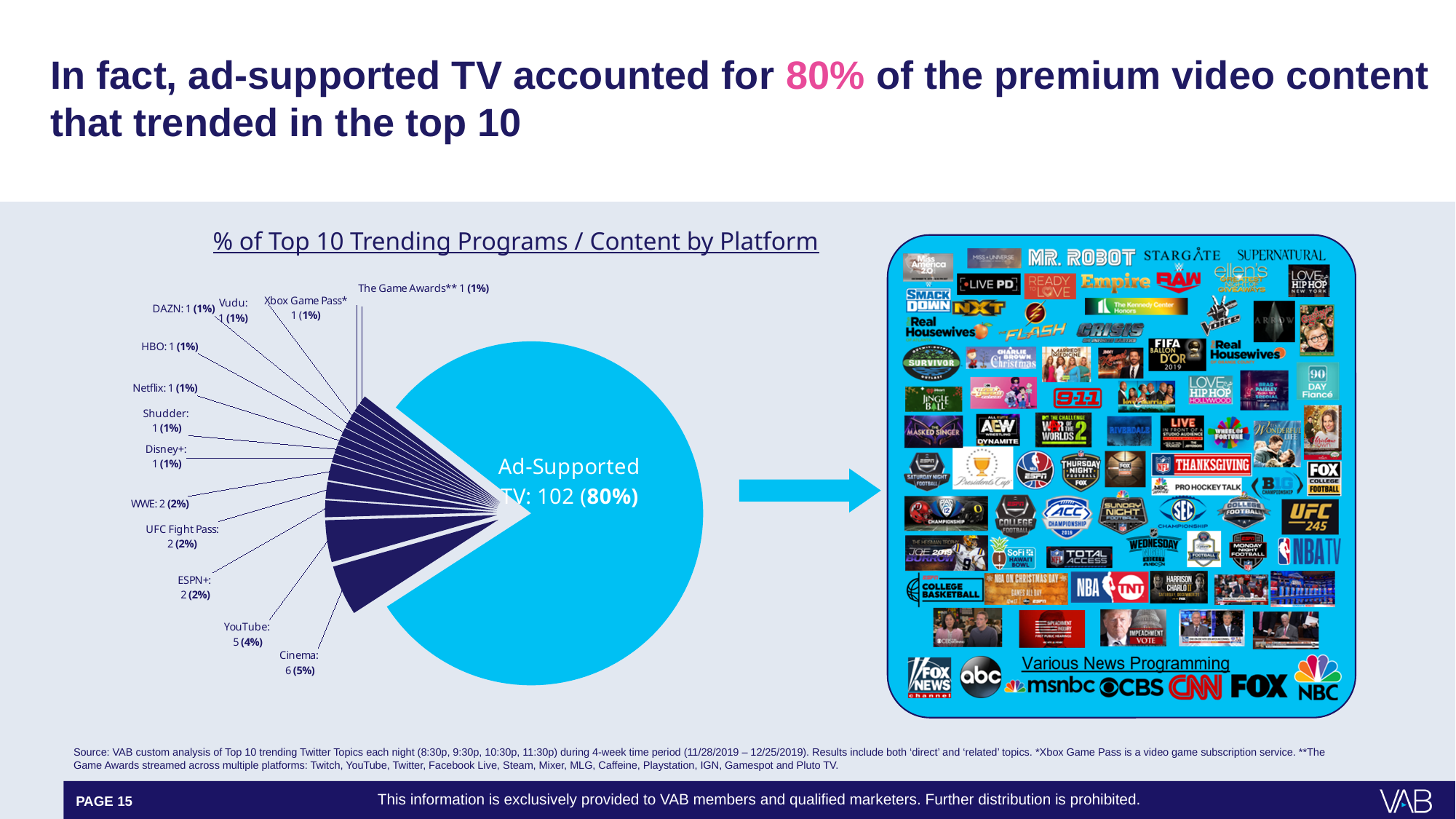
What percentage share is shown for ESPN+? 2% What share of the pie does Ad-Supported TV account for? 80% Which platform has the largest slice of the pie? Ad-Supported TV What is the value shown for Netflix? 1 (1%) What kind of chart is shown on the slide? Pie chart What is the title of the chart? % of Top 10 Trending Programs / Content by Platform What is the difference between the count for Ad-Supported TV and the count for Cinema? 96 What is the value shown for Cinema? 6 (5%) How many trending programs are attributed to Ad-Supported TV in the chart? 102 How many platform categories are shown in the pie chart? 14 Which is larger, the value for Cinema or the value for YouTube? Cinema What is the value shown for YouTube? 5 (4%)